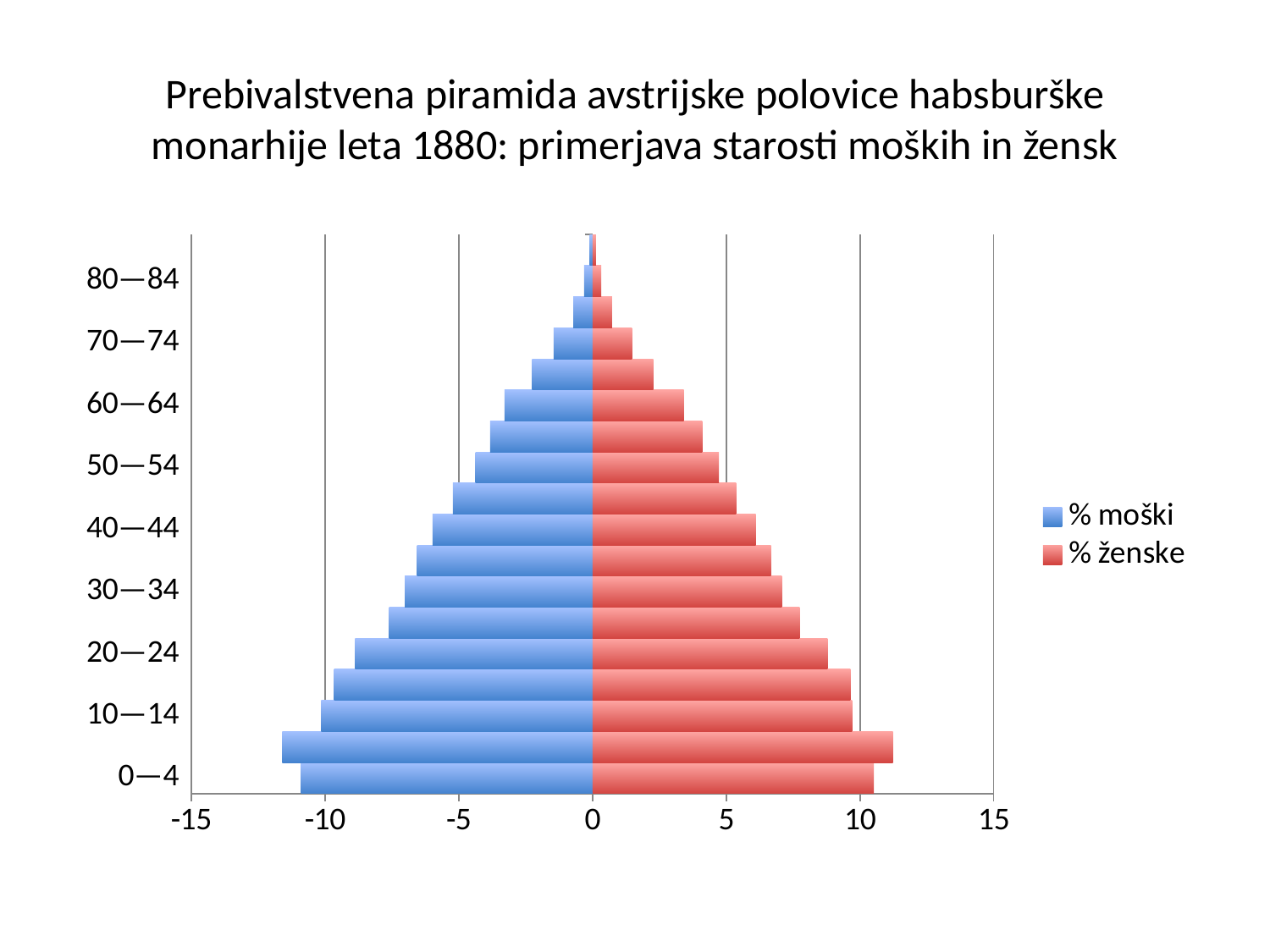
Which age group has the larger % ženske bar, 10—14 or 20—24? 10—14 Which series is shown in red? % ženske Is the value for % ženske in the 60—64 age group greater or less than 5? less Which series is shown in blue? % moški Is the value for % ženske in the 30—34 age group greater or less than 5? greater Which age group has the larger % ženske bar, 0—4 or 40—44? 0—4 What kind of chart is shown on the slide? bar chart Is the value for % ženske in the 70—74 age group greater or less than 5? less Do the bars get longer or shorter as the age groups increase from 0—4 to 80—84? shorter How many series does the legend list? 2